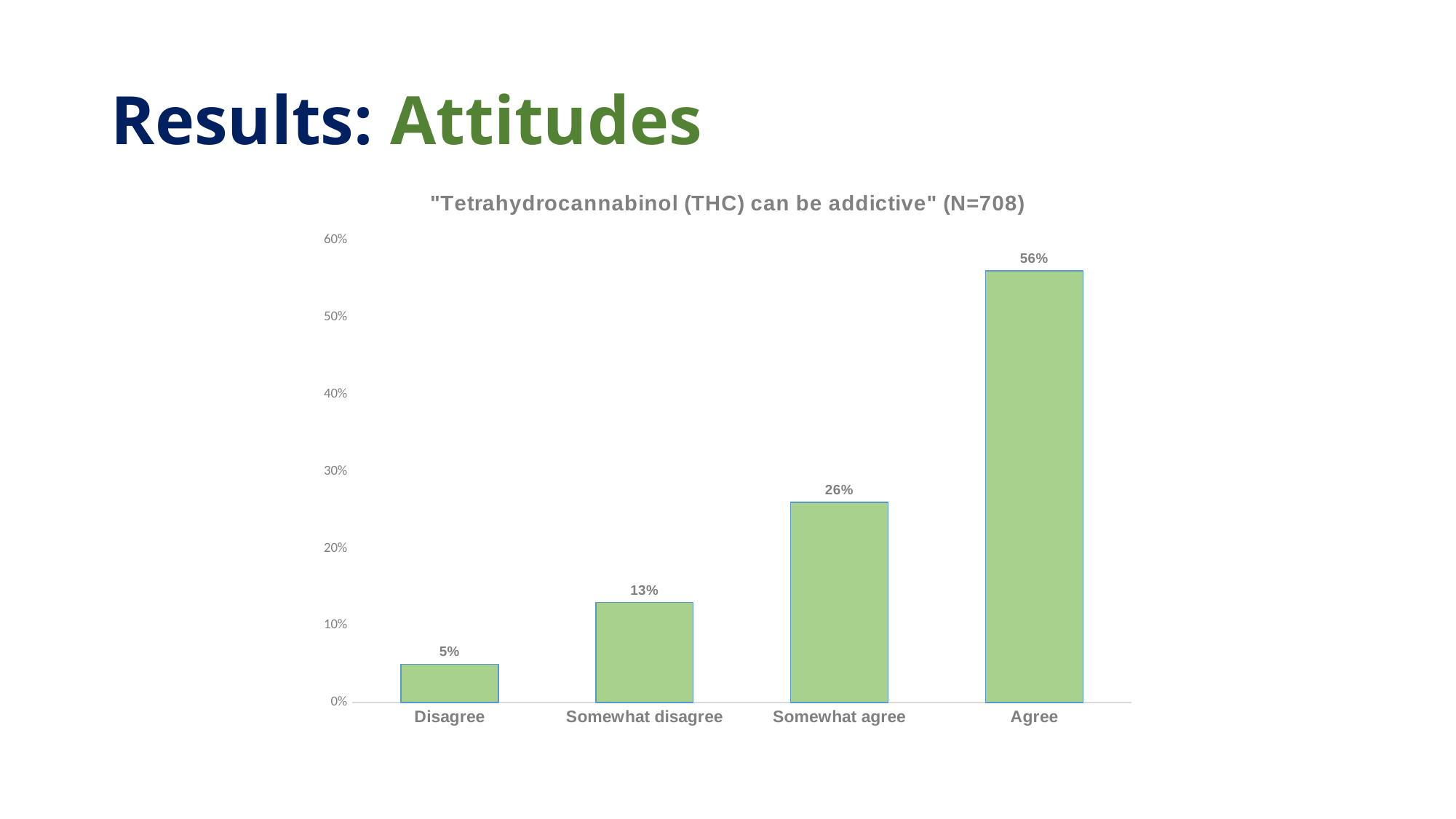
What is the value for "Somewhat agree"? 26% Is the value for "Agree" greater or less than 50%? greater What is the difference between the values for "Somewhat disagree" and "Disagree"? 8% What kind of chart is shown on the slide? Bar chart Do the values rise or fall moving from "Disagree" to "Agree" along the x axis? Rise What is the value for "Somewhat disagree"? 13% Which response category has the lowest value? Disagree How many response categories are shown on the x axis? 4 What is the difference between the values for "Agree" and "Somewhat agree"? 30% Which is larger, the value for "Somewhat agree" or the value for "Somewhat disagree"? Somewhat agree Which response category has the highest value? Agree What percentage of respondents chose "Agree"? 56%